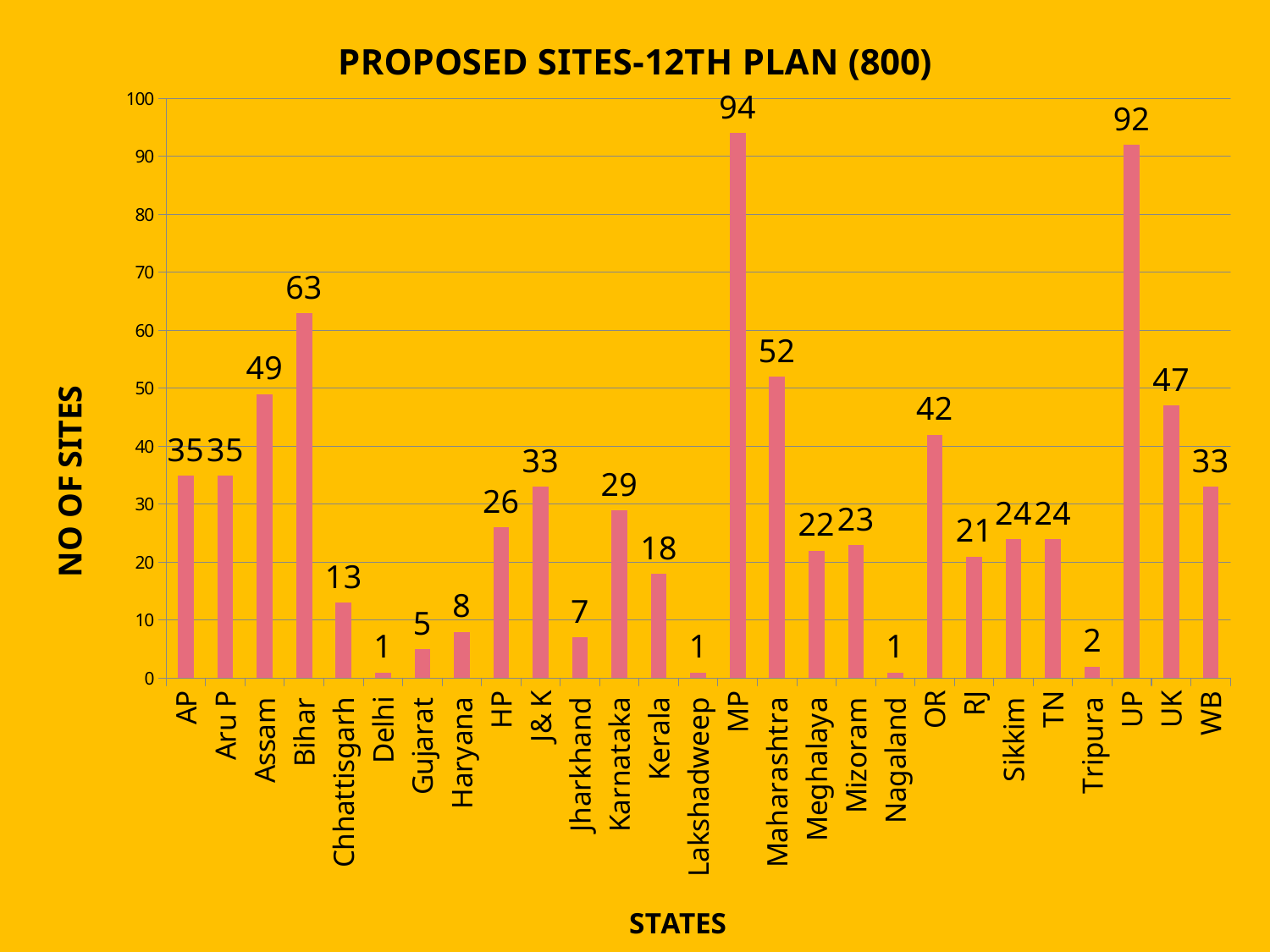
What is the difference in proposed sites between Assam and Chhattisgarh? 36 Which has more proposed sites, HP or Karnataka? Karnataka What is the number of proposed sites for Kerala? 18 What type of chart is shown on the slide? Bar chart What is the number of proposed sites for Maharashtra? 52 Which has more proposed sites, OR or UK? UK What is the number of proposed sites for Bihar? 63 How many states are shown on the x axis? 27 Which state has the highest number of proposed sites? MP What is the label of the y axis? NO OF SITES What is the difference in proposed sites between MP and UP? 2 What is the title of the chart? PROPOSED SITES-12TH PLAN (800)